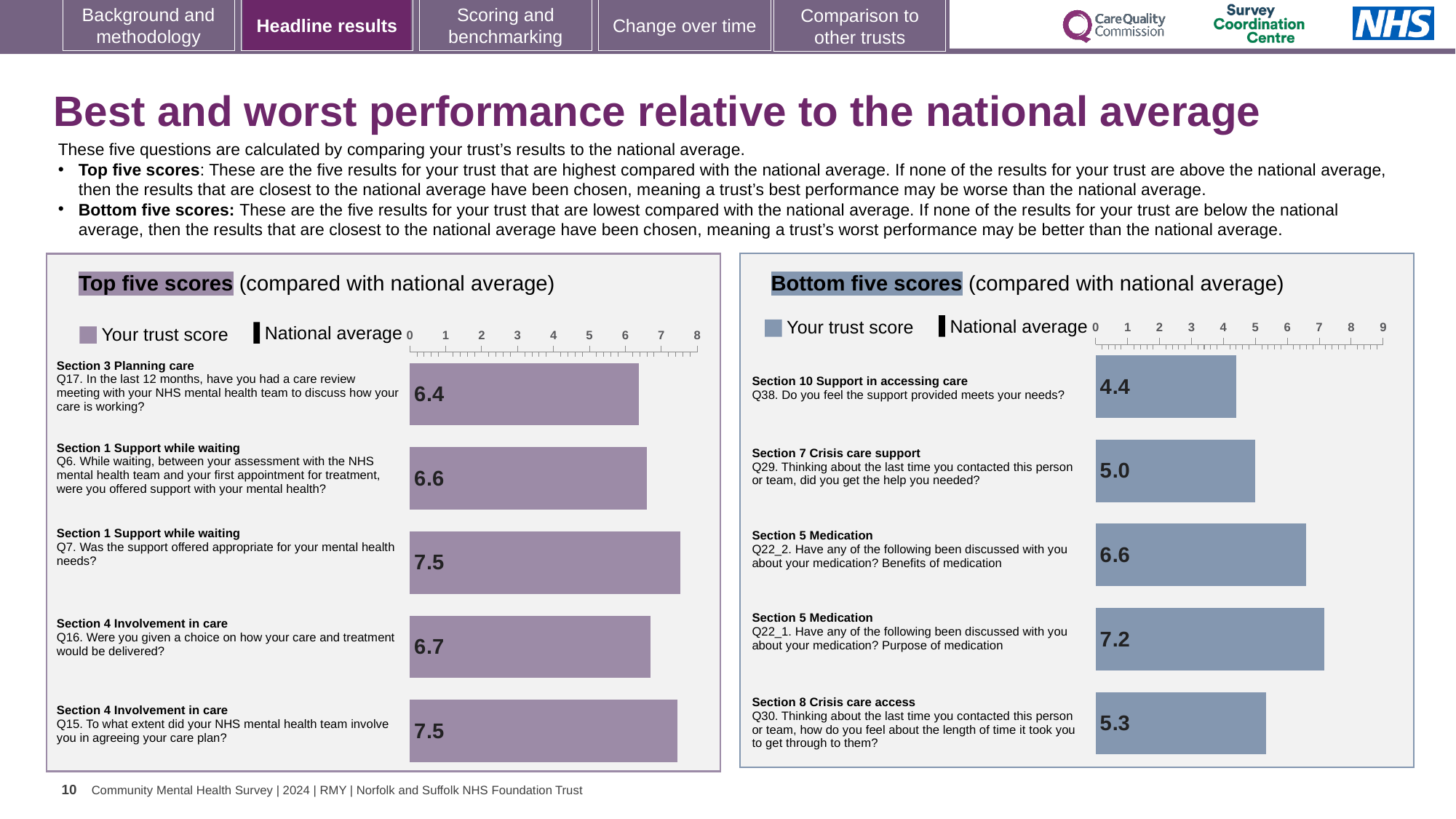
How many questions are shown in the Bottom five scores chart? 5 In the Bottom five scores chart, what is the difference between the trust scores for Q22_1 (purpose of medication) and Q38 (support meets your needs)? 2.8 In the Bottom five scores chart, what is the trust score for Q30 about the length of time it took to get through to the crisis care person or team? 5.3 In the Top five scores chart, what is the trust score for Q17 about having a care review meeting in the last 12 months? 6.4 How many entries does the legend of the Bottom five scores chart list? 2 In the Bottom five scores chart, which question has the lowest trust score? Q38. Do you feel the support provided meets your needs? In the Bottom five scores chart, what is the trust score for Q38 about whether the support provided meets your needs? 4.4 In the Top five scores chart, which has the larger trust score: Q6 (offered support while waiting) or Q7 (support offered appropriate)? Q7 What type of chart is used for the Top five scores? Bar chart In the Top five scores chart, which question has the lowest trust score? Q17. Care review meeting in the last 12 months In the Top five scores chart, what is the trust score for Q16 about being given a choice on how care and treatment would be delivered? 6.7 In the Bottom five scores chart, which question has the highest trust score? Q22_1. Purpose of medication